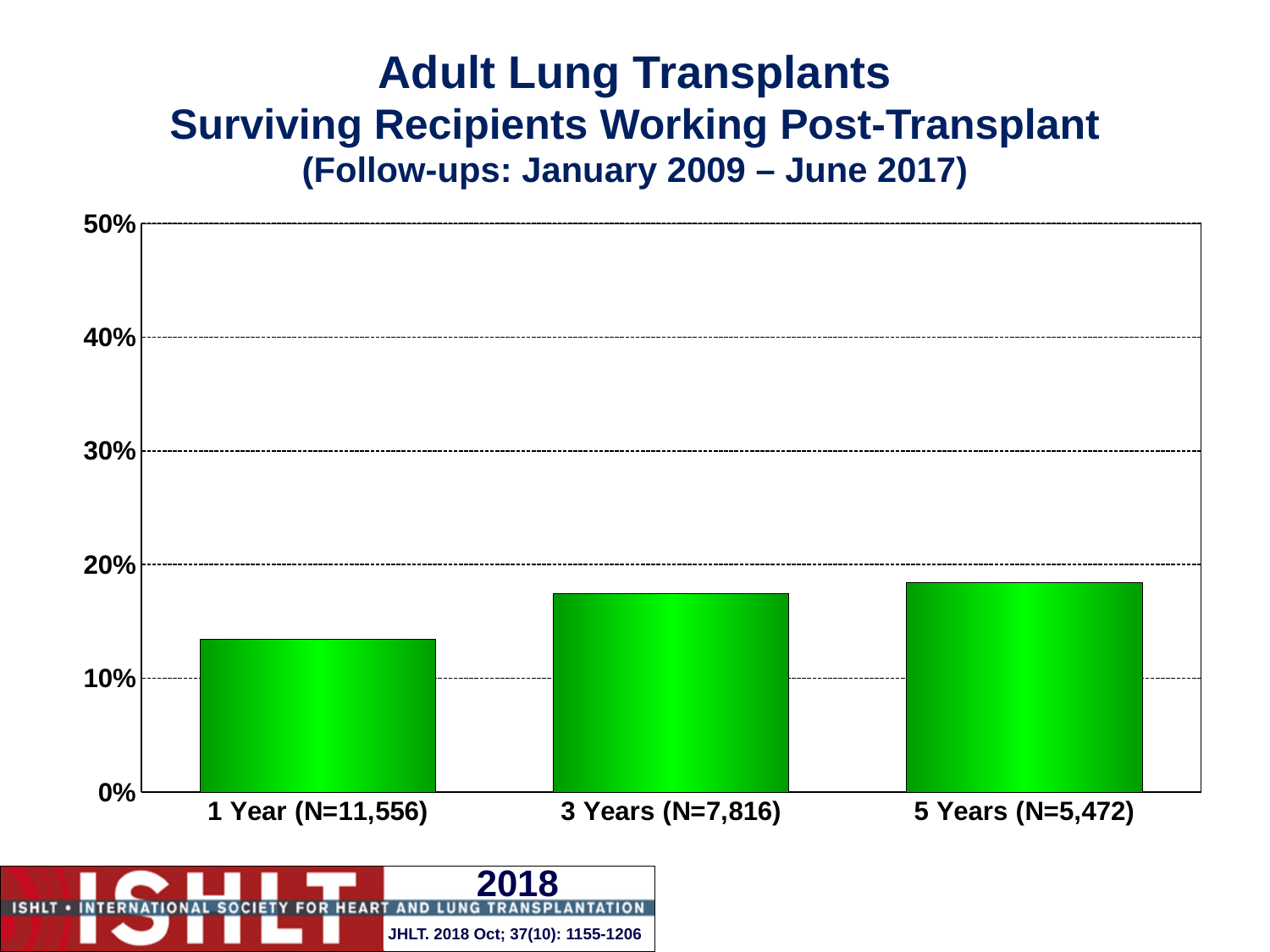
Is the value for 1 Year greater or less than 10%? greater Is the value for 3 Years greater or less than 20%? less How many categories (follow-up time points) are shown on the x axis? 3 Is the value for 1 Year greater or less than 20%? less Which follow-up time point has the lowest percentage of surviving recipients working post-transplant? 1 Year (N=11,556) Which follow-up time point has the highest percentage of surviving recipients working post-transplant? 5 Years (N=5,472) What follow-up period is stated in the chart title? January 2009 – June 2017 What kind of chart is shown on the slide? bar chart Which is larger, the value for 1 Year or the value for 3 Years? 3 Years What is the N (number of recipients) shown for the 1 Year category? 11,556 Do the values rise or fall from 1 Year to 5 Years along the x axis? rise